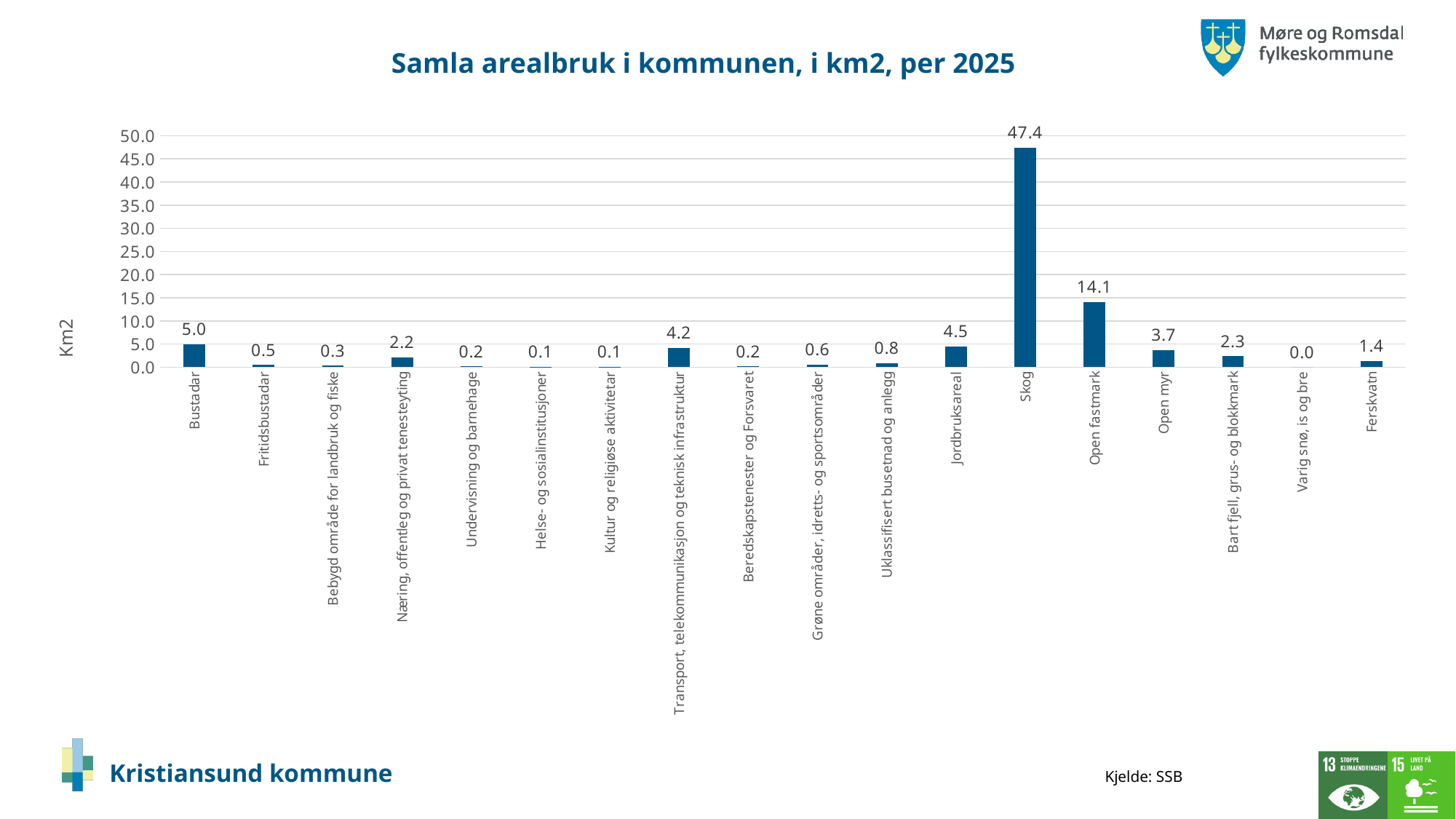
Which category has the highest value? Skog What is the value for Open fastmark? 14.1 What is the value for Skog? 47.4 Is the value for Skog greater or less than 45.0? greater What kind of chart is shown on the slide? bar chart What is the value for Jordbruksareal? 4.5 What is the difference between the values for Skog and Open fastmark? 33.3 Which is larger, the value for Open myr or the value for Bart fjell, grus- og blokkmark? Open myr What is the value for Bustadar? 5.0 How many categories are shown on the x axis? 18 What is the title of the chart? Samla arealbruk i kommunen, i km2, per 2025 Which category has the lowest value? Varig snø, is og bre